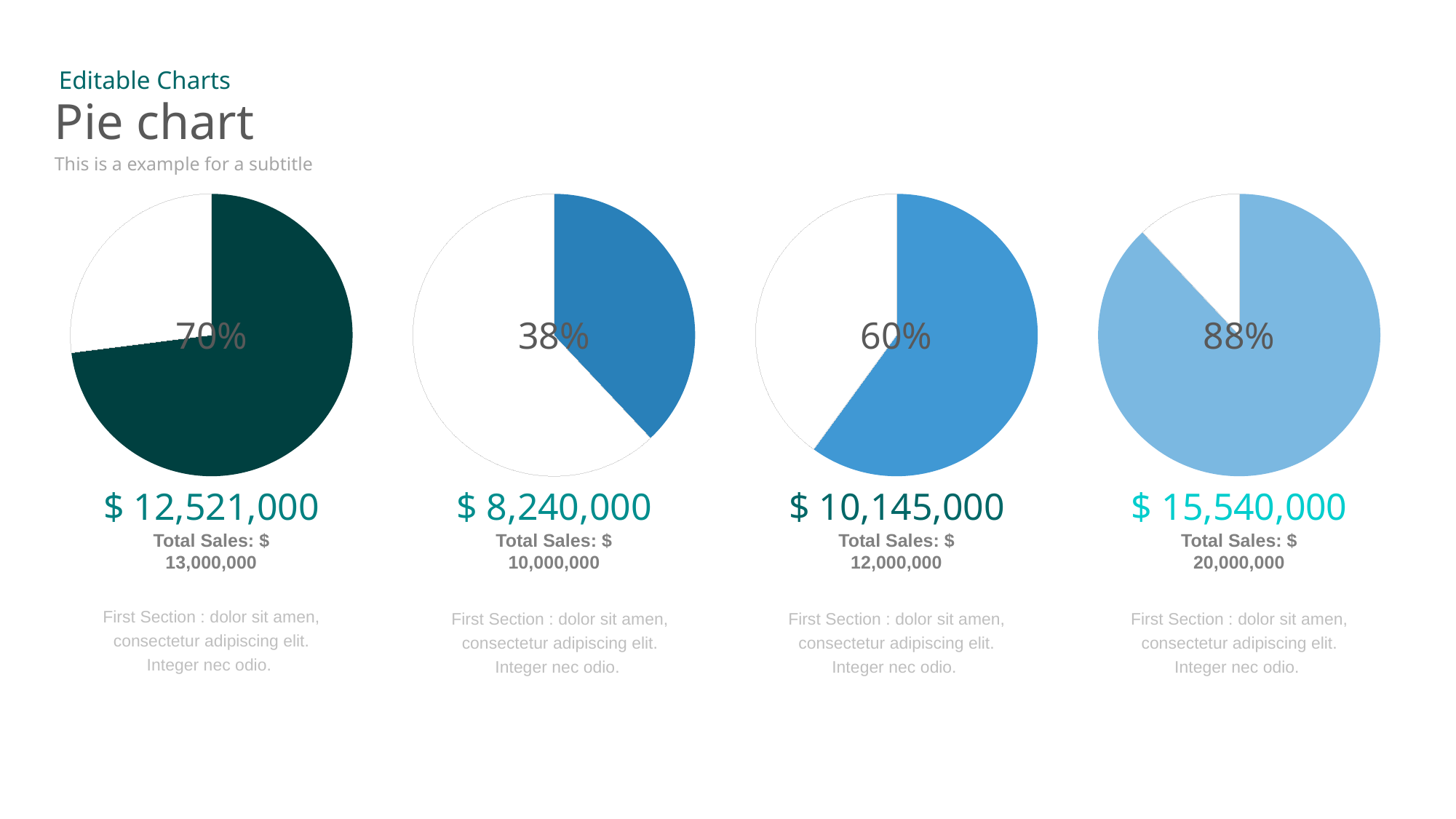
What type of chart is used on this slide? Pie chart What percentage is shown in the leftmost pie chart? 70% What percentage is shown in the third pie chart from the left? 60% Which is larger: the percentage in the third pie chart or the percentage in the second pie chart? The third pie chart (60%) How many pie charts are shown on the slide? 4 What dollar amount is printed below the leftmost pie chart? $ 12,521,000 What percentage is shown in the rightmost pie chart? 88% What is the Total Sales figure printed below the rightmost pie chart? $ 20,000,000 What is the difference between the percentage in the rightmost pie chart and the percentage in the leftmost pie chart? 18% What percentage is shown in the second pie chart from the left? 38% Which of the four pie charts shows the lowest percentage? The second pie chart from the left (38%) Which of the four pie charts shows the highest percentage? The rightmost pie chart (88%)